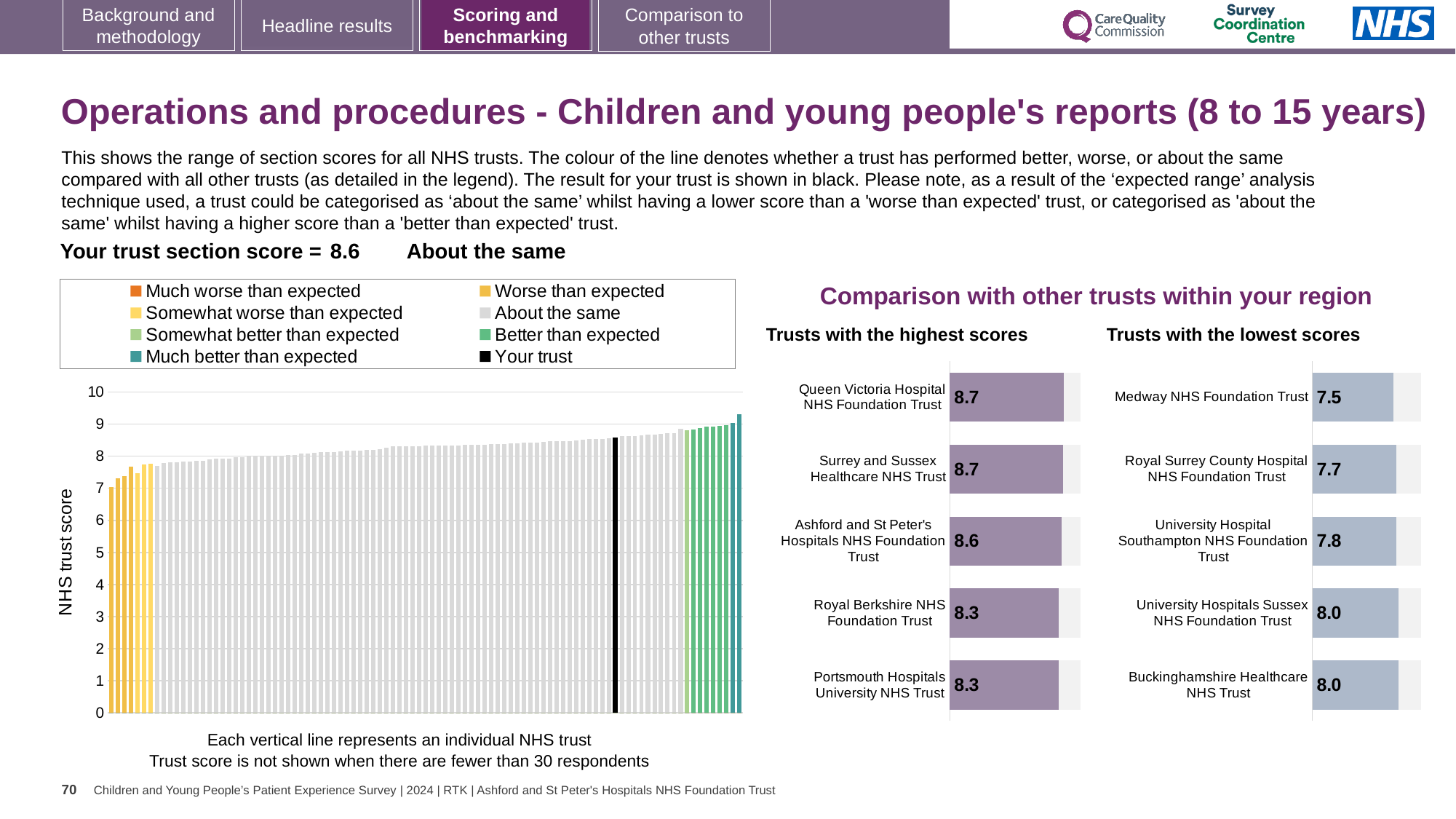
In the 'Trusts with the highest scores' chart, what is the score for Queen Victoria Hospital NHS Foundation Trust? 8.7 In the 'Trusts with the lowest scores' chart, what is the score for University Hospital Southampton NHS Foundation Trust? 7.8 In the 'Trusts with the lowest scores' chart, which trust has the lowest score? Medway NHS Foundation Trust What kind of chart is the large chart on the left showing NHS trust scores? Bar chart In the 'Trusts with the highest scores' chart, what is the score for Royal Berkshire NHS Foundation Trust? 8.3 What is the difference between Queen Victoria Hospital NHS Foundation Trust's score in the 'highest scores' chart and Medway NHS Foundation Trust's score in the 'lowest scores' chart? 1.2 In the large NHS trust score chart on the left, do the bars rise or fall from left to right? Rise How many trusts are listed in the 'Trusts with the highest scores' chart? 5 How many entries does the legend of the large NHS trust score chart list? 8 In the 'Trusts with the lowest scores' chart, which has the larger score: Medway NHS Foundation Trust or University Hospitals Sussex NHS Foundation Trust? University Hospitals Sussex NHS Foundation Trust In the large NHS trust score chart on the left, is the value of the tallest bar greater or less than 9? greater In the 'Trusts with the lowest scores' chart, what is the difference between Buckinghamshire Healthcare NHS Trust and Medway NHS Foundation Trust? 0.5